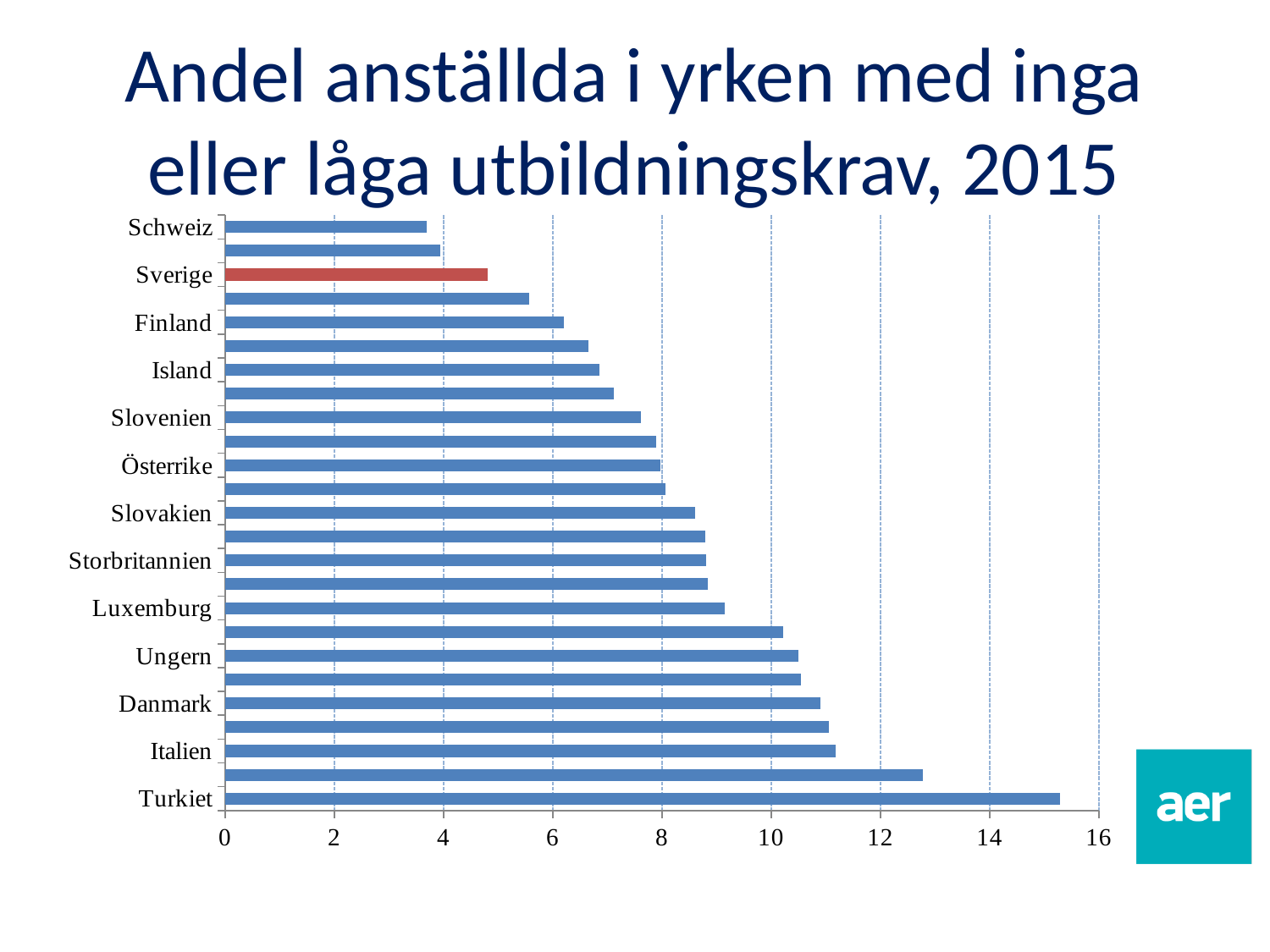
Is the value for Schweiz greater or less than 4? less Is the value for Italien greater or less than 12? less What is the title of the chart? Andel anställda i yrken med inga eller låga utbildningskrav, 2015 Is the value for Ungern greater or less than 10? greater What kind of chart is shown on the slide? bar chart Which has the larger value, Danmark or Sverige? Danmark Which bar is highlighted in a different colour (red) from the others? Sverige Which country has the highest value in the chart? Turkiet Which country has the lowest value in the chart? Schweiz